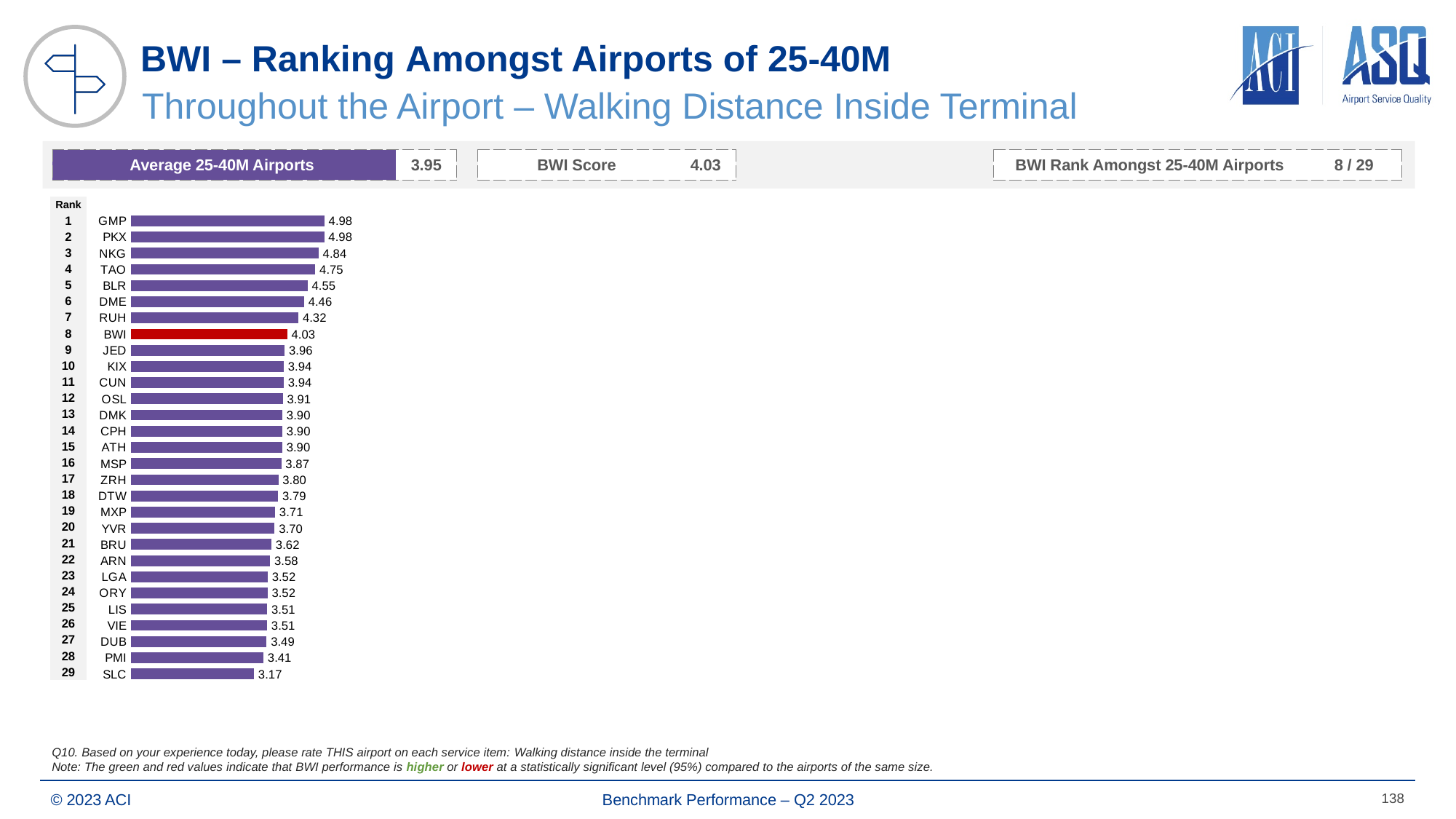
How many airports are ranked in the chart? 29 Which bar in the chart is coloured red? BWI What is the score for BWI in the chart? 4.03 Which airport has the lowest score in the chart? SLC What is the difference between the scores of GMP and BWI? 0.95 What is BWI's rank amongst 25-40M airports? 8 / 29 Which has a higher score, TAO or DME? TAO Which has a higher score, MSP or BRU? MSP What kind of chart is shown on the slide? Bar chart What is the difference between the scores of BWI and SLC? 0.86 What is the score for RUH in the chart? 4.32 What is the score for SLC in the chart? 3.17